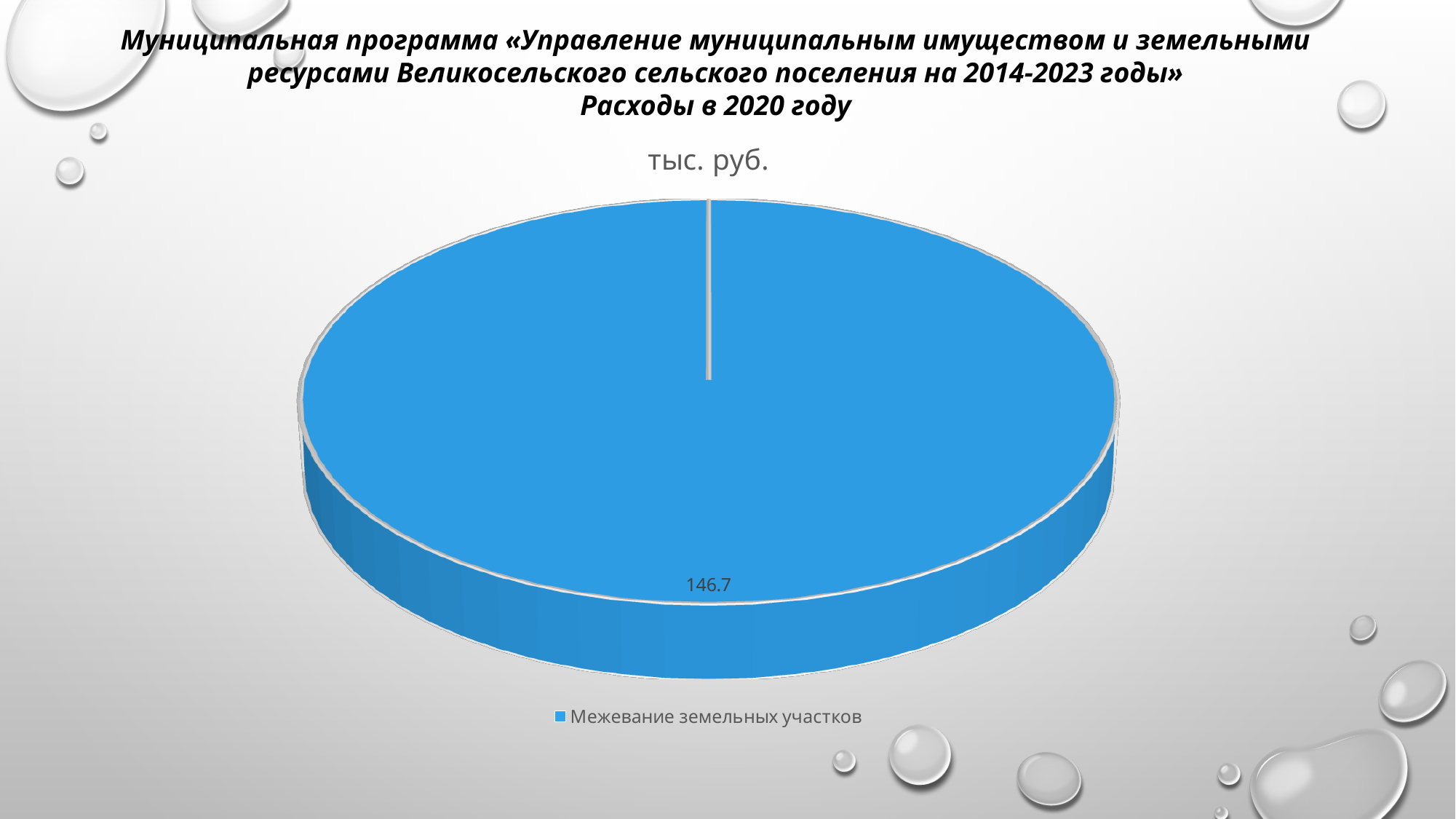
What share of the pie does Межевание земельных участков take? 100% What colour is the slice for Межевание земельных участков? blue Is the value for Межевание земельных участков greater or less than 100? greater How many slices does the pie chart have? 1 What is the value for Межевание земельных участков? 146.7 What is the chart's title? тыс. руб. How many entries does the legend list? 1 What kind of chart is shown on the slide? pie chart